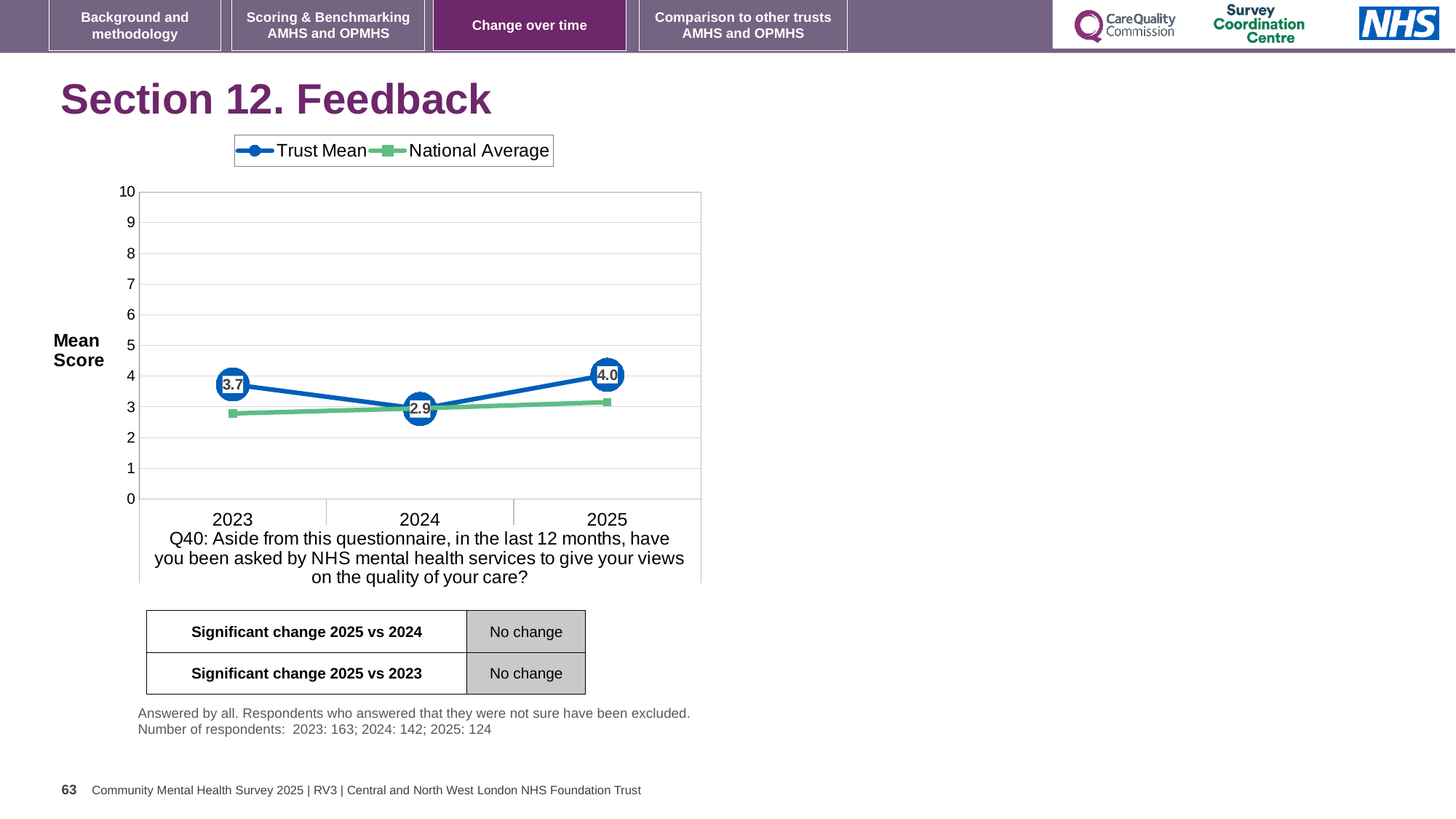
Which is larger, the Trust Mean in 2023 or in 2025? 2025 In which year is the Trust Mean lowest? 2024 What is the difference between the Trust Mean in 2025 and in 2024? 1.1 Is the National Average value for 2023 greater or less than 3? less What is the Trust Mean score for 2023? 3.7 What is the Trust Mean score for 2025? 4.0 How many series does the legend list? 2 How many years are shown on the x axis? 3 What is the Trust Mean score for 2024? 2.9 Does the National Average rise or fall from 2023 to 2025? rise In which year is the Trust Mean highest? 2025 What kind of chart is shown on the slide? line chart